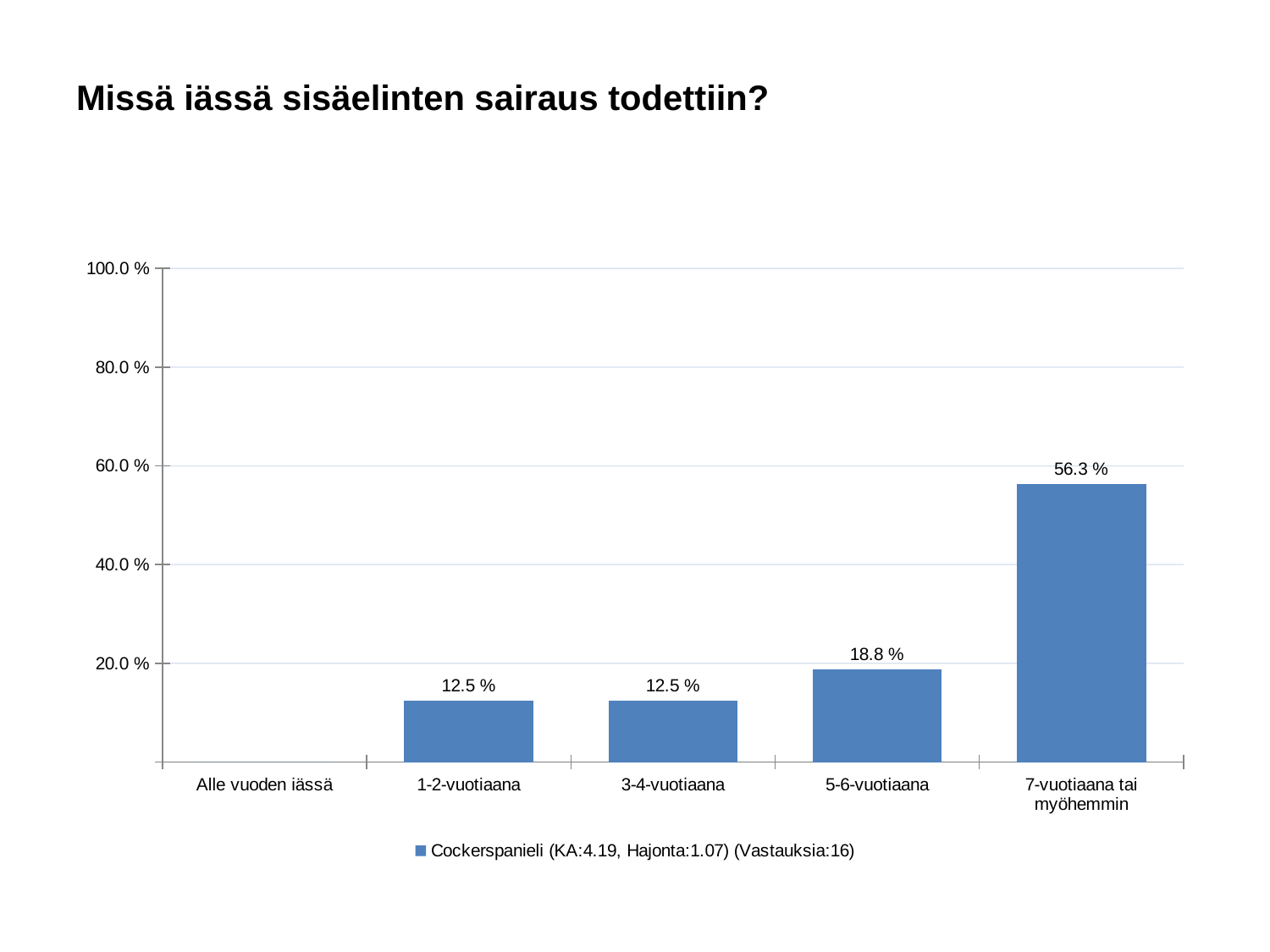
Which category has the highest value? 7-vuotiaana tai myöhemmin What is the value for 1-2-vuotiaana? 12.5 % How many categories are shown on the x axis? 5 Is the value for 7-vuotiaana tai myöhemmin greater or less than 40.0 %? greater Which is larger, the value for 5-6-vuotiaana or the value for 3-4-vuotiaana? 5-6-vuotiaana What kind of chart is shown on the slide? bar chart What is the value for 5-6-vuotiaana? 18.8 % What is the difference between the values for 7-vuotiaana tai myöhemmin and 5-6-vuotiaana? 37.5 % How many series does the legend list? 1 How many responses (Vastauksia) does the legend entry report? 16 What is the value for 7-vuotiaana tai myöhemmin? 56.3 % What is the title of the slide? Missä iässä sisäelinten sairaus todettiin?